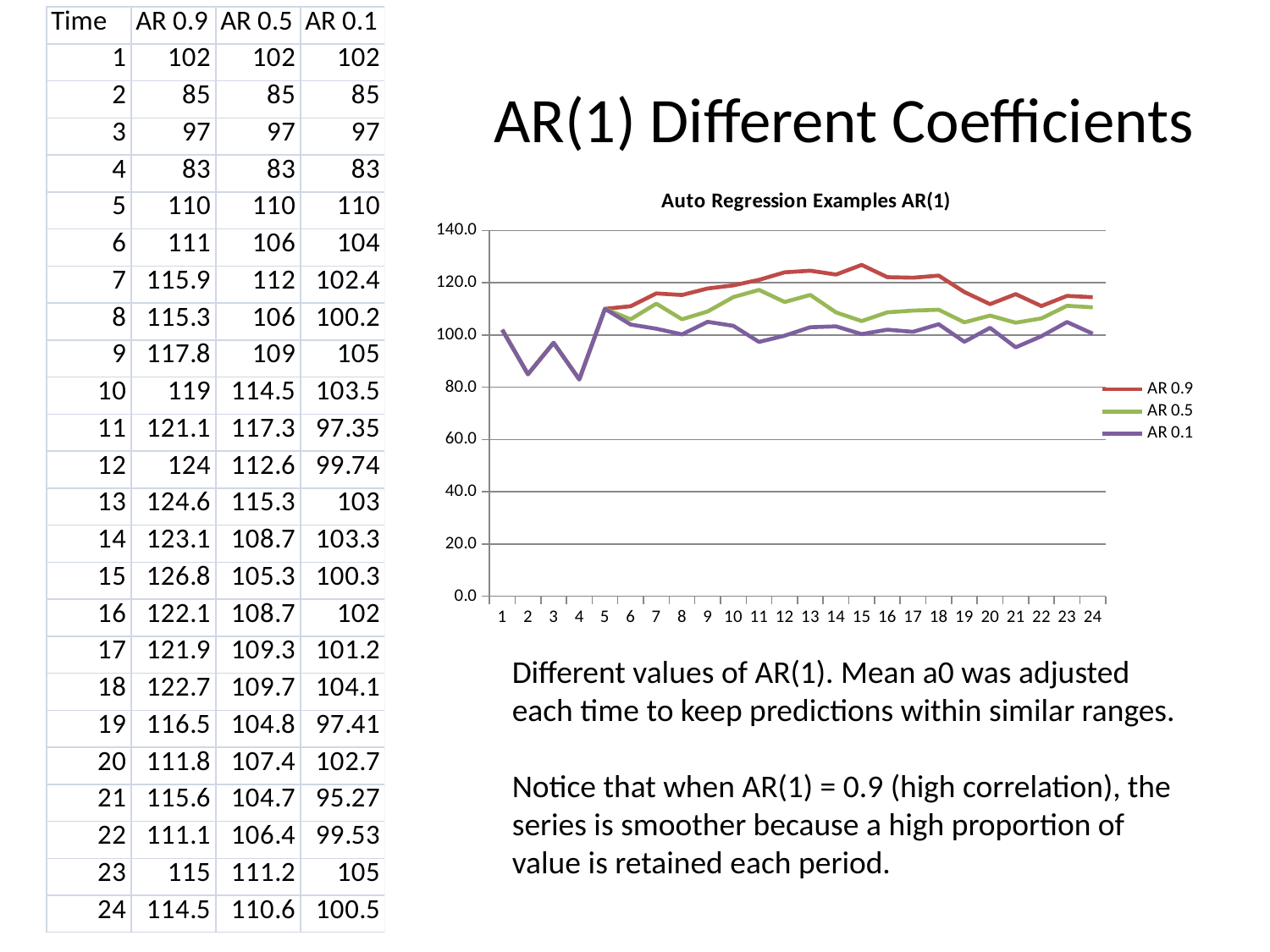
Does the AR 0.9 series generally rise or fall between time 5 and time 15? rise Which series reaches the highest value in the chart? AR 0.9 What is the title of the chart? Auto Regression Examples AR(1) At time 13, which series has the larger value, AR 0.9 or AR 0.1? AR 0.9 How many series does the chart legend list? 3 What is the difference between AR 0.9 and AR 0.1 at time 24? 14 Is the value of AR 0.1 at time 21 greater or less than 100? less What kind of chart is shown on the slide? line chart What is the value of AR 0.9 at time 15? 126.8 How many time points are plotted along the x axis of the chart? 24 Which colour is used for the AR 0.9 series in the chart? red Is the value of AR 0.9 at time 15 greater or less than 120? greater